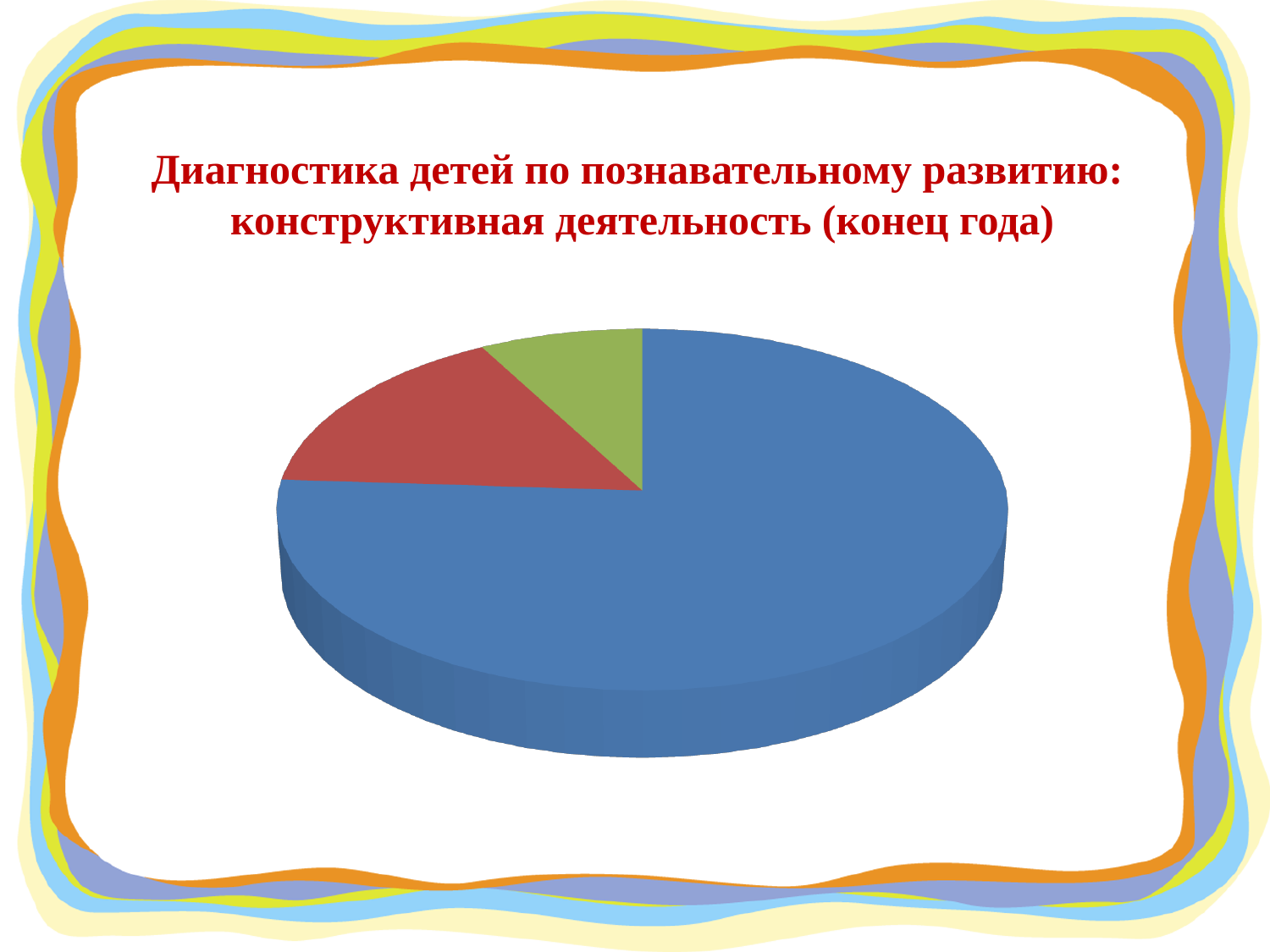
Which colour slice is the largest in the pie chart? blue Which slice is larger, the red one or the green one? red Which colour slice is the smallest in the pie chart? green What kind of chart is shown on the slide? pie chart What is the title shown above the chart on the slide? Диагностика детей по познавательному развитию: конструктивная деятельность (конец года) How many slices does the pie chart have? 3 Does the pie chart have a legend? no Which slice is larger, the blue one or the red one? blue Does the blue slice take up more or less than half of the pie? more Does the green slice take up more or less than a quarter of the pie? less